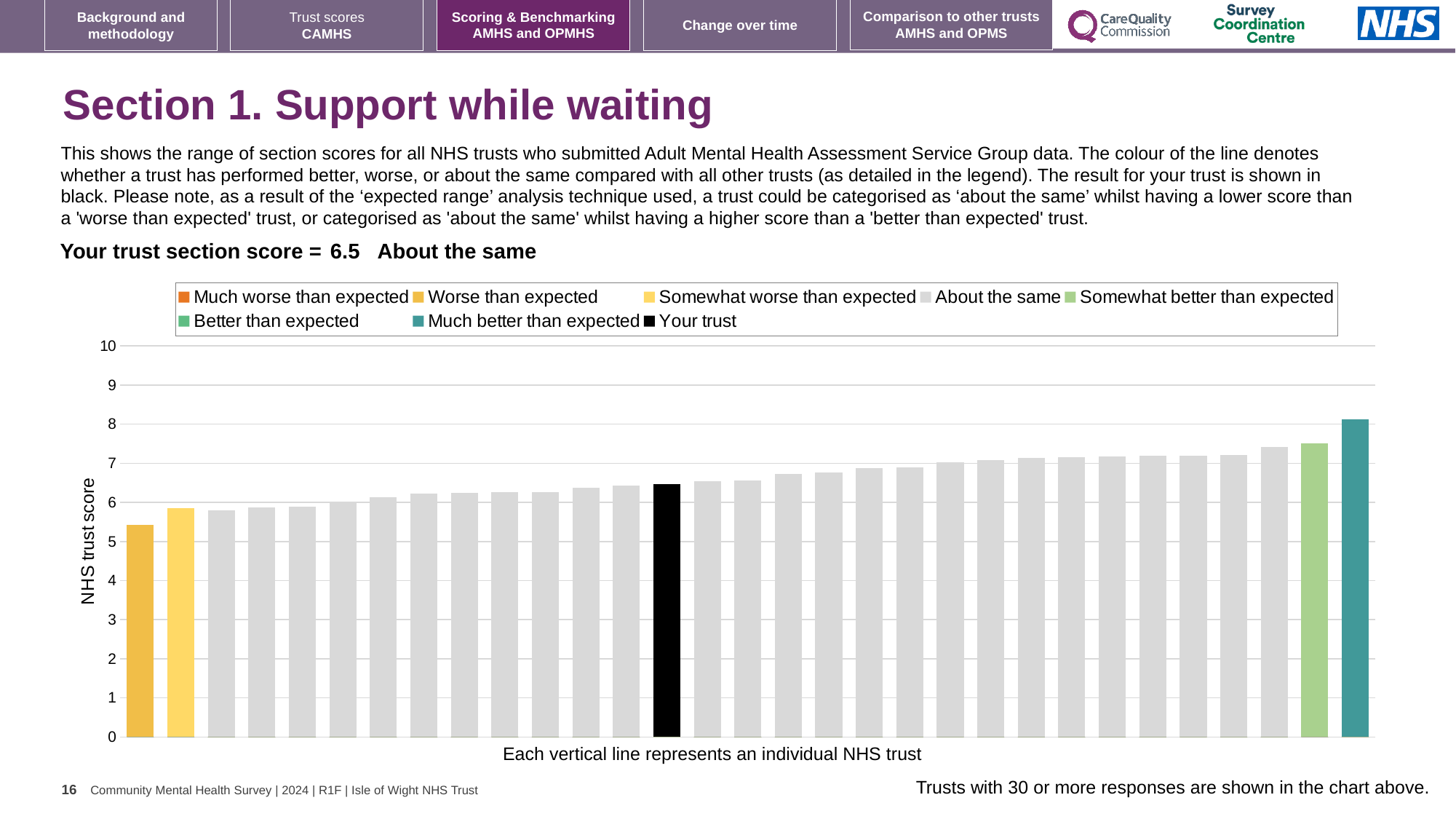
What is the section score for your trust shown in the chart? 6.5 Is the value for the green 'Somewhat better than expected' bar greater or less than 7? greater Which is larger: the score for your trust (black bar) or the score for the rightmost teal bar? The rightmost teal bar Is the value for the black 'Your trust' bar greater or less than 7? less Do the bar values rise or fall from left to right across the chart? rise What kind of chart is shown on the slide? bar chart How many vertical bars (NHS trusts) are plotted in the chart? 31 Is the value for the leftmost bar greater or less than 6? less What is the label on the vertical axis of the chart? NHS trust score Which bar has the lowest score in the chart? The leftmost (gold, worse than expected) bar Which bar has the highest score in the chart? The rightmost (teal, much better than expected) bar How many entries does the chart legend list? 8